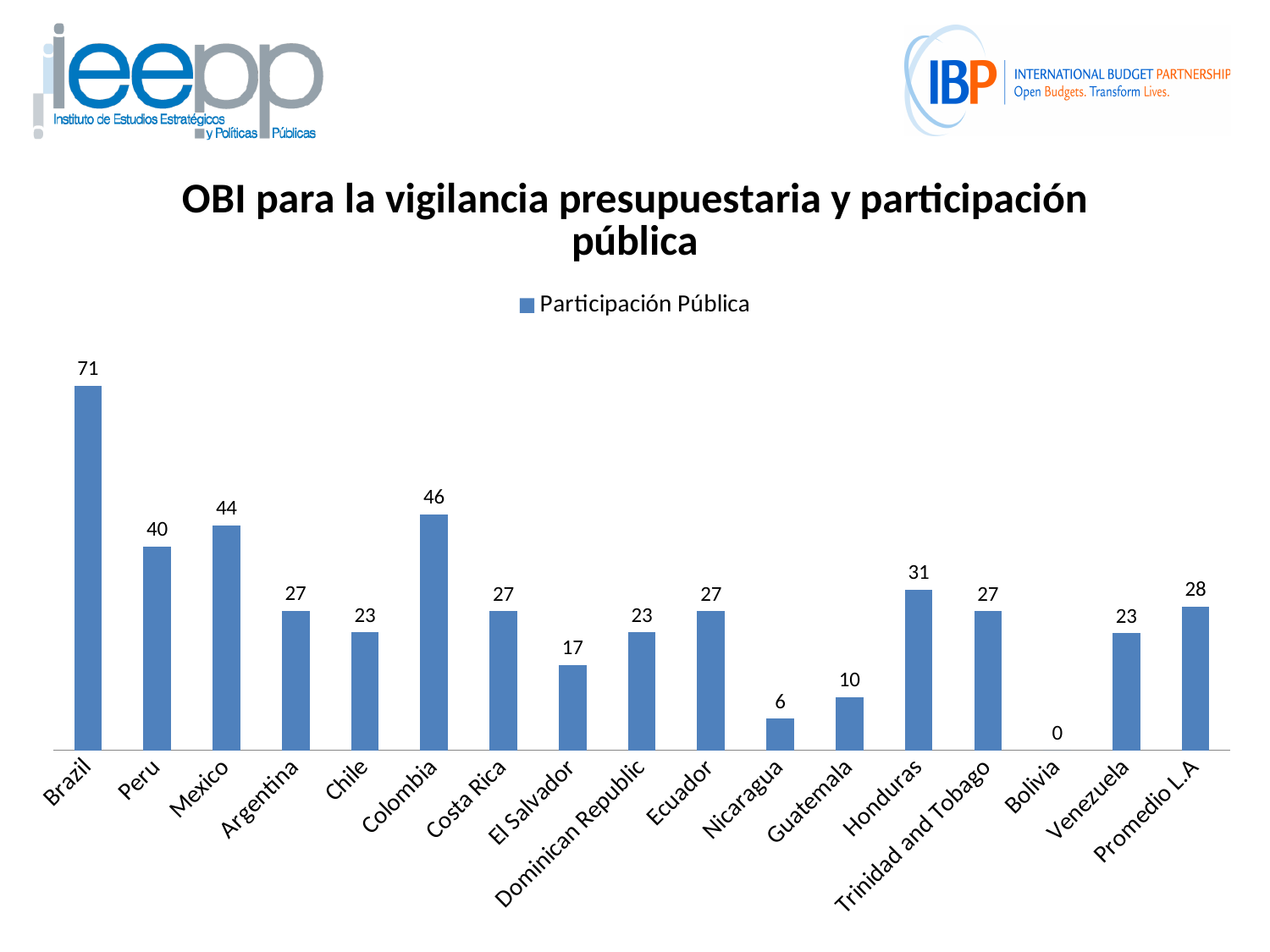
What is the Participación Pública value for Brazil? 71 Which has a higher value, Honduras or Guatemala? Honduras What is the Participación Pública value for Colombia? 46 What kind of chart is shown on the slide? Bar chart Which country has the highest Participación Pública value? Brazil Which country has the lowest Participación Pública value? Bolivia What is the difference between the values for Mexico and Colombia? 2 What is the difference between the values for Brazil and Peru? 31 How many categories are shown on the x axis of the chart? 17 Which has a higher value, Nicaragua or El Salvador? El Salvador How many series does the legend list? 1 What is the value shown for Promedio L.A? 28